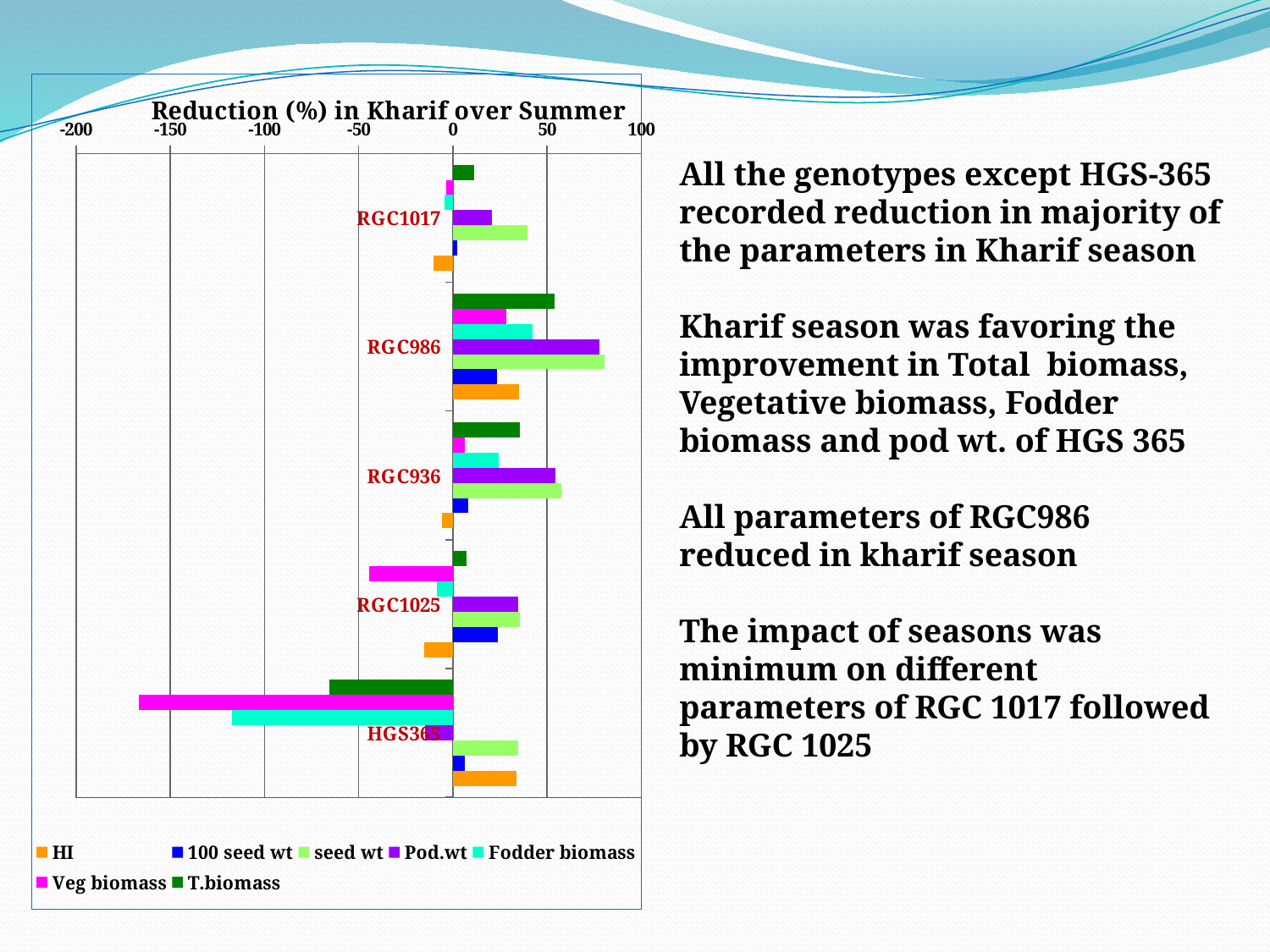
How many series does the chart legend list? 7 What kind of chart is shown on the slide? bar chart Is the seed wt value for RGC1017 greater or less than 50? less Is the Veg biomass value for RGC1025 greater or less than 0? less Which genotype has the lowest (most negative) Veg biomass value? HGS365 Is the Veg biomass value for HGS365 greater or less than -150? less How many genotypes (categories) are plotted on the chart? 5 Which genotype has the highest Pod.wt value? RGC986 What is the title of the chart? Reduction (%) in Kharif over Summer